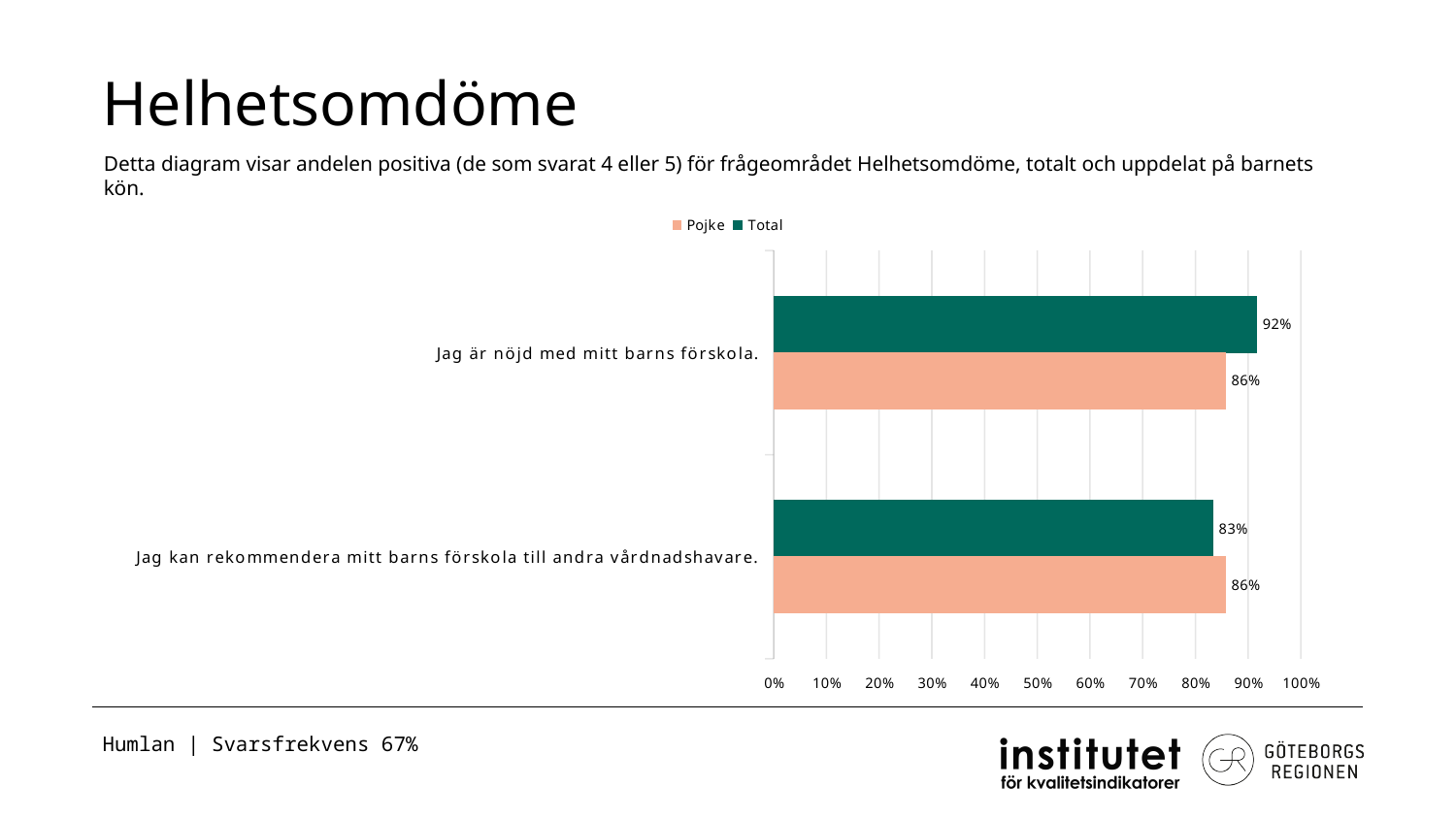
For "Jag kan rekommendera mitt barns förskola till andra vårdnadshavare.", which is larger, the Pojke value or the Total value? Pojke What is the Pojke value for "Jag är nöjd med mitt barns förskola."? 86% What is the difference between the Total and Pojke values for "Jag är nöjd med mitt barns förskola."? 6% What is the Total value for "Jag kan rekommendera mitt barns förskola till andra vårdnadshavare."? 83% What is the Total value for "Jag är nöjd med mitt barns förskola."? 92% Which category has the highest Total value? Jag är nöjd med mitt barns förskola. What is the Pojke value for "Jag kan rekommendera mitt barns förskola till andra vårdnadshavare."? 86% Is the Total value for "Jag kan rekommendera mitt barns förskola till andra vårdnadshavare." greater or less than 90%? less How many series does the legend list? 2 How many categories are plotted on the chart? 2 Which series is shown in dark green? Total What kind of chart is shown on the slide? bar chart